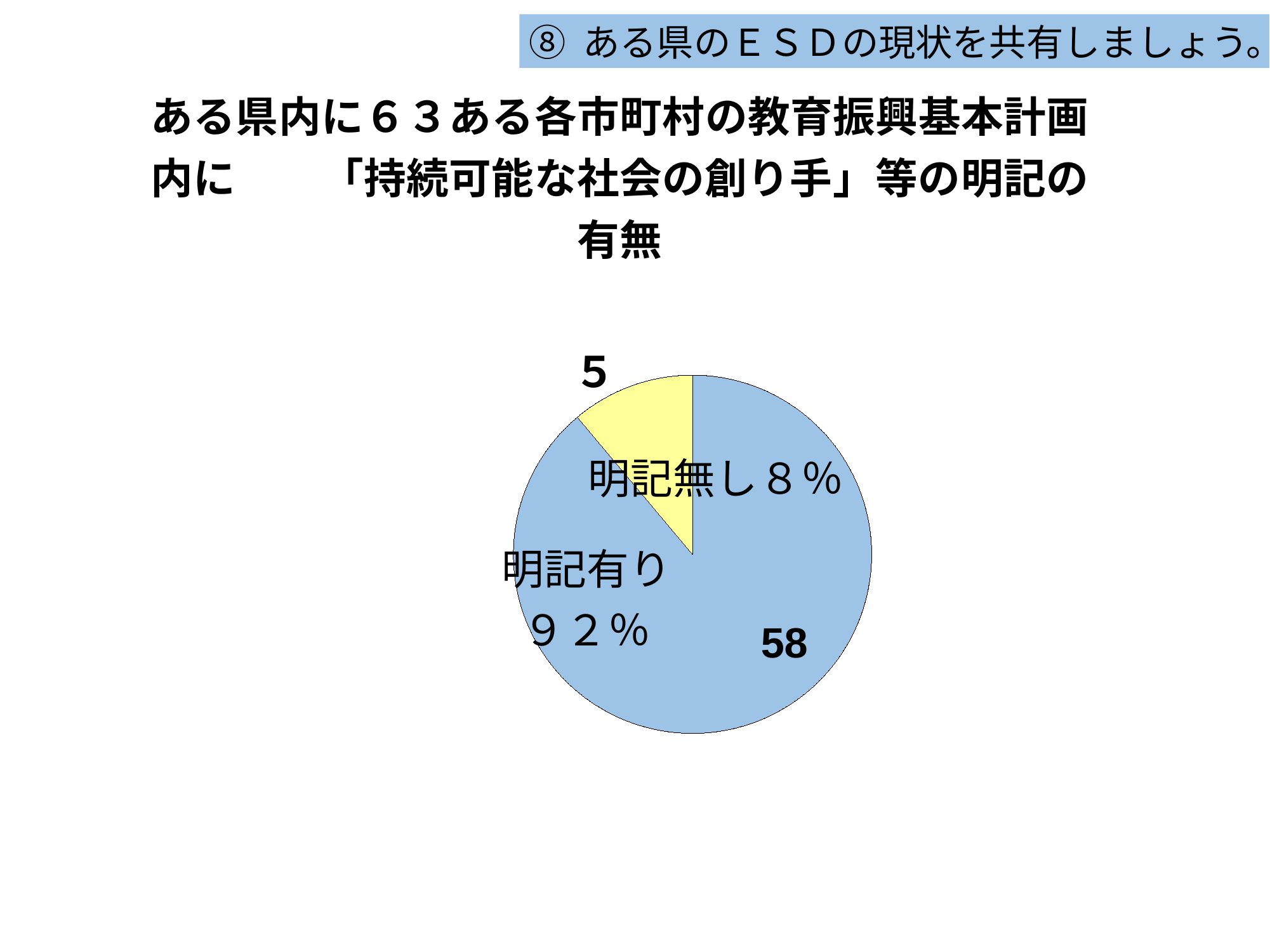
What colour is the 明記無し slice? yellow What is the total of the two slice values in the pie chart? 63 What is the difference between the values for 明記有り and 明記無し? 53 What share of the pie does 明記無し represent, as printed on the slide? ８％ Which slice is the largest in the pie chart? 明記有り What is the value shown for 明記有り? 58 Which is larger, 明記有り or 明記無し? 明記有り What is the value shown for 明記無し? 5 Which slice is the smallest in the pie chart? 明記無し What share of the pie does 明記有り represent, as printed on the slide? ９２％ What kind of chart is shown on the slide? pie chart How many slices does the pie chart have? 2